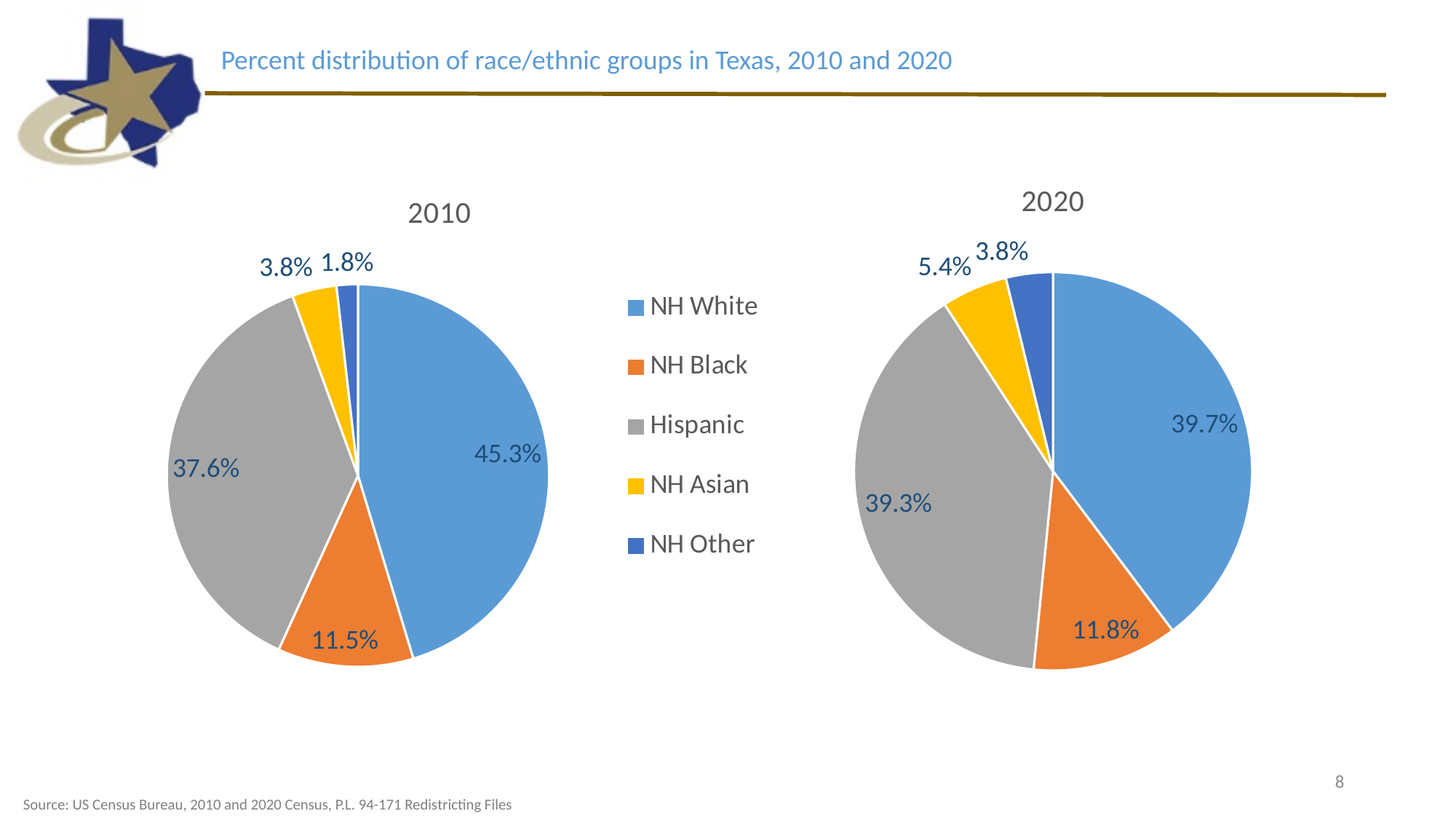
What is the difference between the NH Asian share in 2020 and in 2010? 1.6% What type of chart is used on this slide? Pie chart In the 2020 pie chart, what is the value for Hispanic? 39.3% In the 2010 pie chart, which is larger, the Hispanic share or the NH Black share? Hispanic In the 2020 pie chart, what is the value for NH Asian? 5.4% Which colour represents Hispanic in the pie charts? Gray In the 2010 pie chart, which group has the smallest share? NH Other In the 2010 pie chart, what is the value for NH Black? 11.5% What is the difference between the NH White share in 2010 and in 2020? 5.6% In the 2020 pie chart, which group has the largest share? NH White How many categories does each pie chart show? 5 In the 2010 pie chart, what is the value for NH White? 45.3%